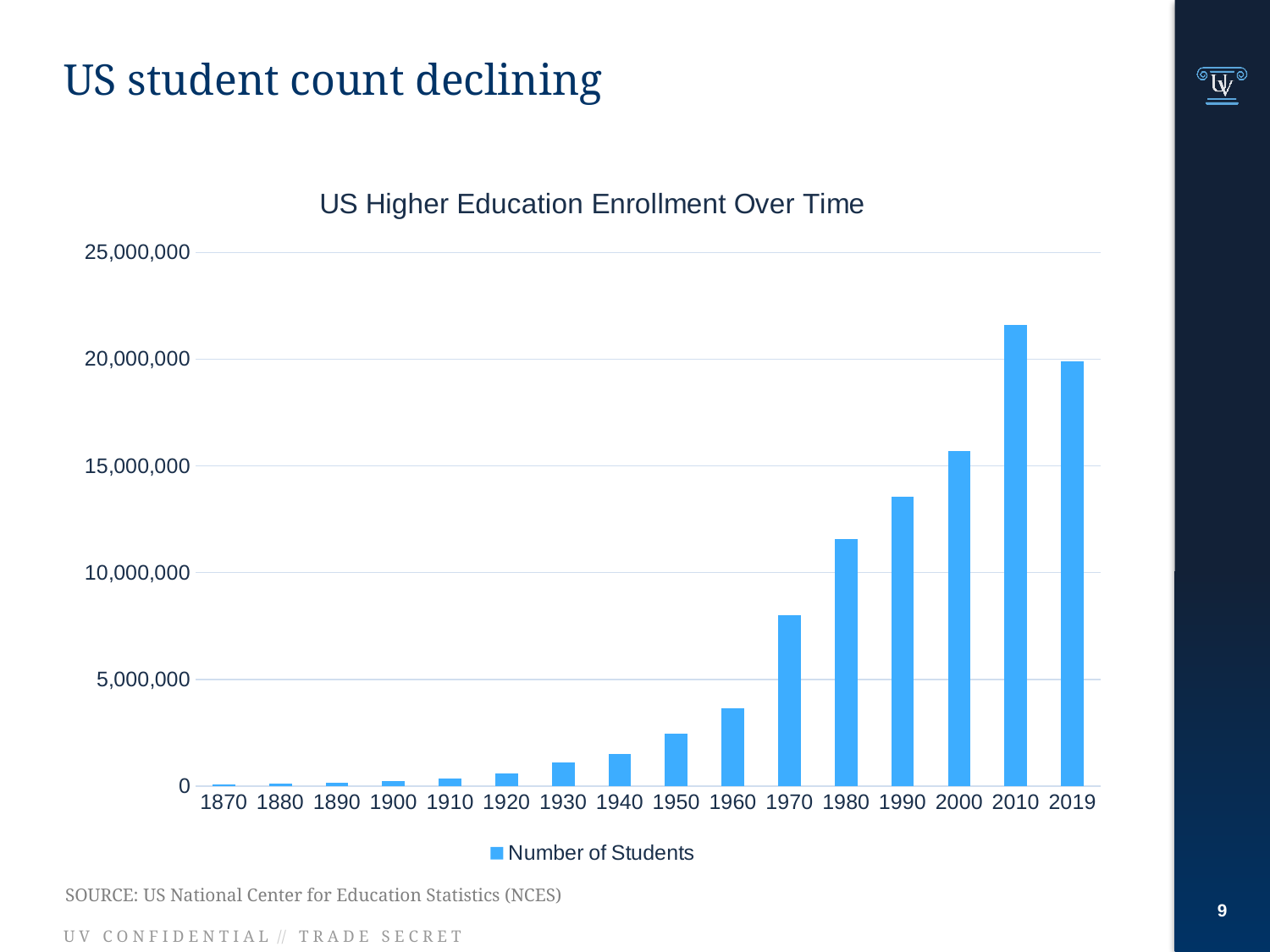
Which year has the highest number of students? 2010 How many years are shown on the x axis? 16 Which year has more students, 2010 or 2019? 2010 How many series does the legend list? 1 What is the title of the chart? US Higher Education Enrollment Over Time Do the values generally rise or fall from 1870 to 2010? rise What kind of chart is shown on the slide? bar chart What is the name of the series shown in the legend? Number of Students Is the value for 2010 greater or less than 20,000,000? greater Is the value for 1970 greater or less than 5,000,000? greater Which year has the lowest number of students? 1870